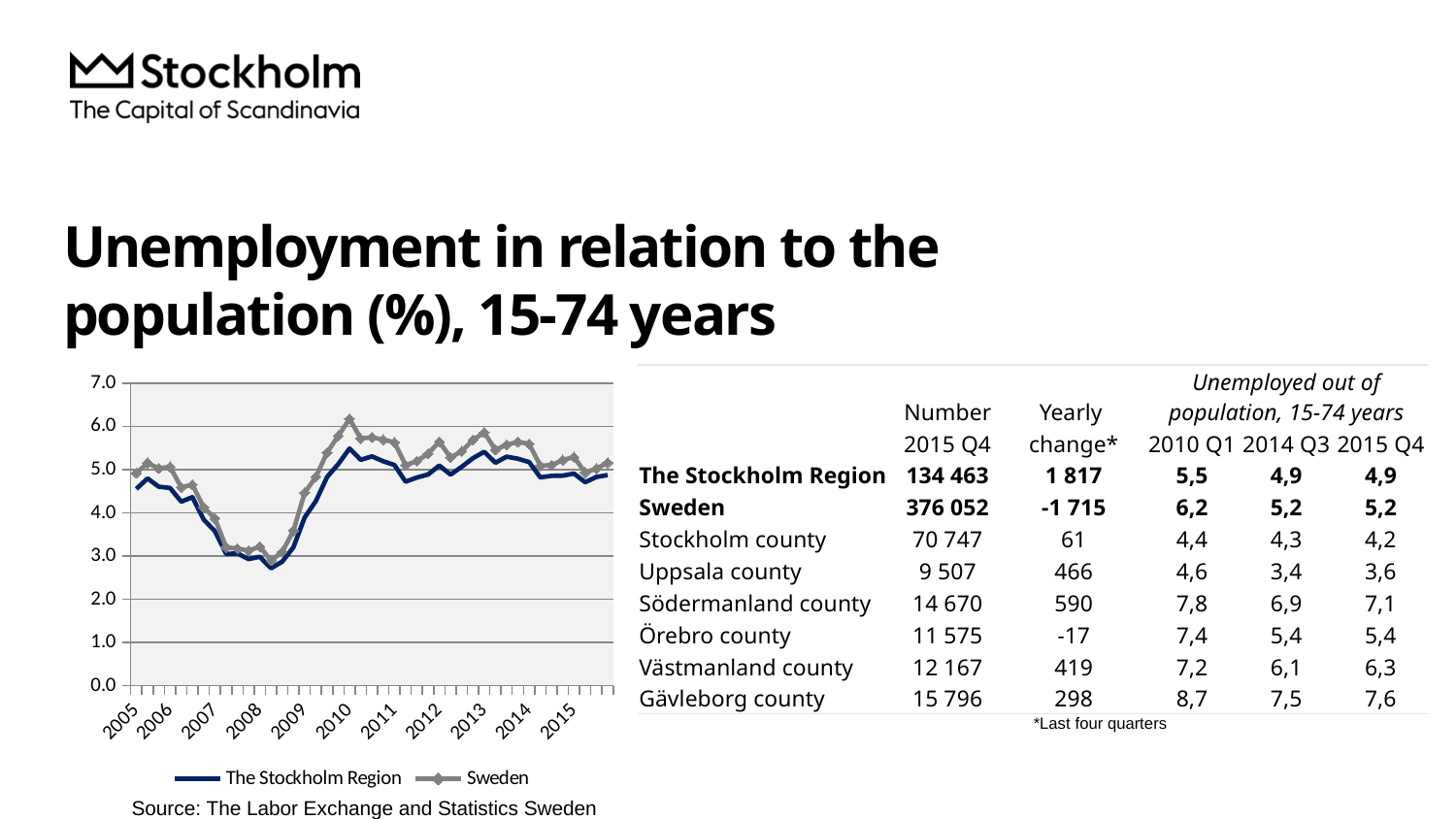
How many year labels are shown along the chart's x axis? 11 Do the values for The Stockholm Region rise or fall between 2006 and 2008? fall Is the peak value for The Stockholm Region around 2010 greater or less than 5.0? greater What kind of chart is shown on the slide? line chart Which series is generally higher across the chart, The Stockholm Region or Sweden? Sweden Which two series are listed in the chart's legend? The Stockholm Region and Sweden Is the peak value for Sweden around 2010 greater or less than 6.0? greater What is the highest value shown on the chart's y axis? 7.0 Do the values for Sweden rise or fall between 2008 and 2010? rise How many series does the chart's legend list? 2 Is the lowest value for The Stockholm Region, around 2008, greater or less than 3.0? less Around 2010, which series has the higher value, The Stockholm Region or Sweden? Sweden